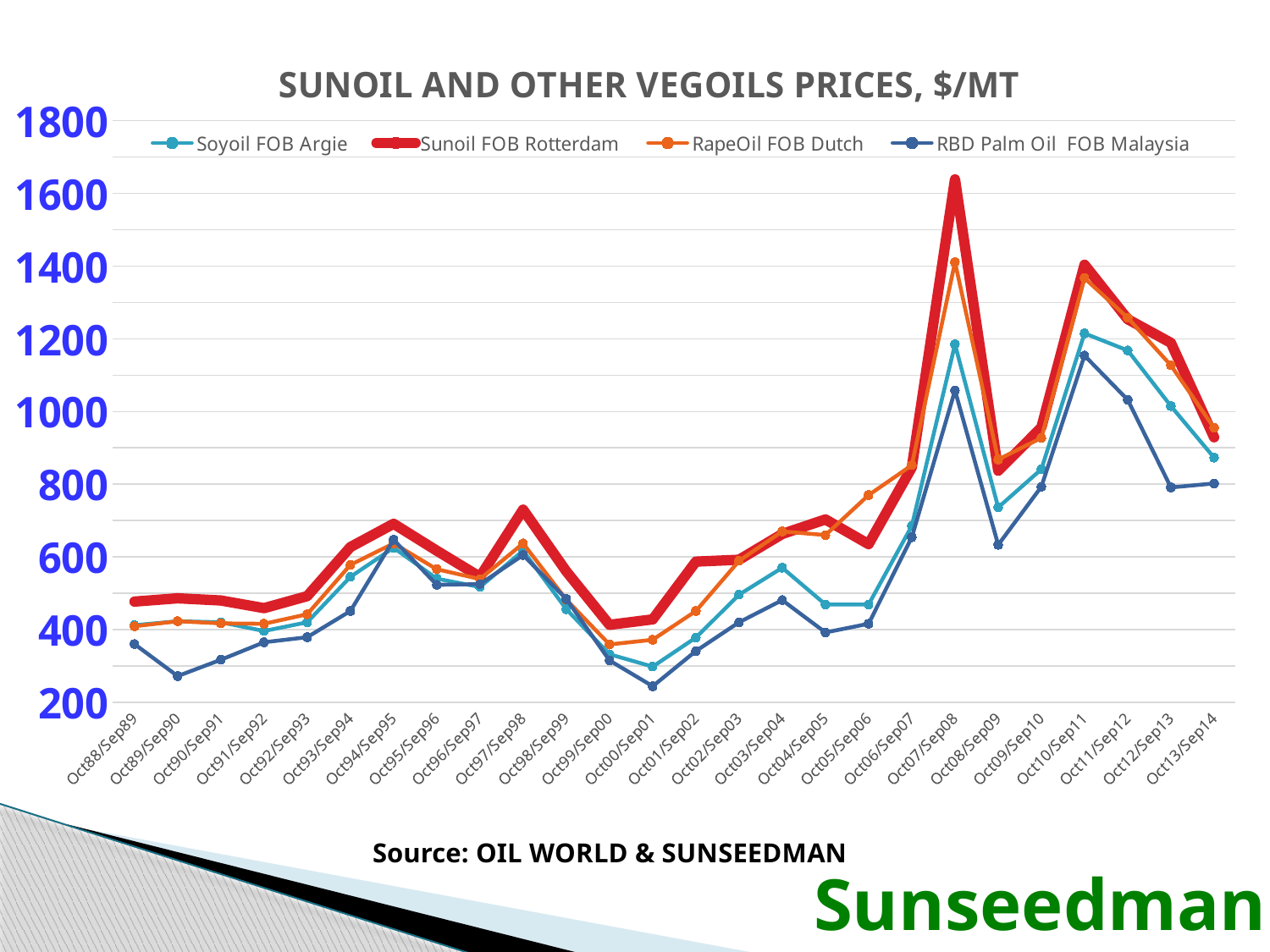
Is the value for Soyoil FOB Argie in Oct13/Sep14 greater or less than 800? greater In Oct10/Sep11, which is higher: Sunoil FOB Rotterdam or RBD Palm Oil FOB Malaysia? Sunoil FOB Rotterdam In which period does Sunoil FOB Rotterdam reach its highest price? Oct07/Sep08 What type of chart is shown on the slide? line chart How many time periods are shown on the x axis? 26 What is the title of the chart? SUNOIL AND OTHER VEGOILS PRICES, $/MT How many series does the legend list? 4 Is the value for RBD Palm Oil FOB Malaysia in Oct89/Sep90 greater or less than 400? less Which series is drawn with the thick red line? Sunoil FOB Rotterdam Which series has the highest value in Oct07/Sep08? Sunoil FOB Rotterdam Is the value for Sunoil FOB Rotterdam in Oct07/Sep08 greater or less than 1600? greater Which series has the lowest value in Oct00/Sep01? RBD Palm Oil FOB Malaysia